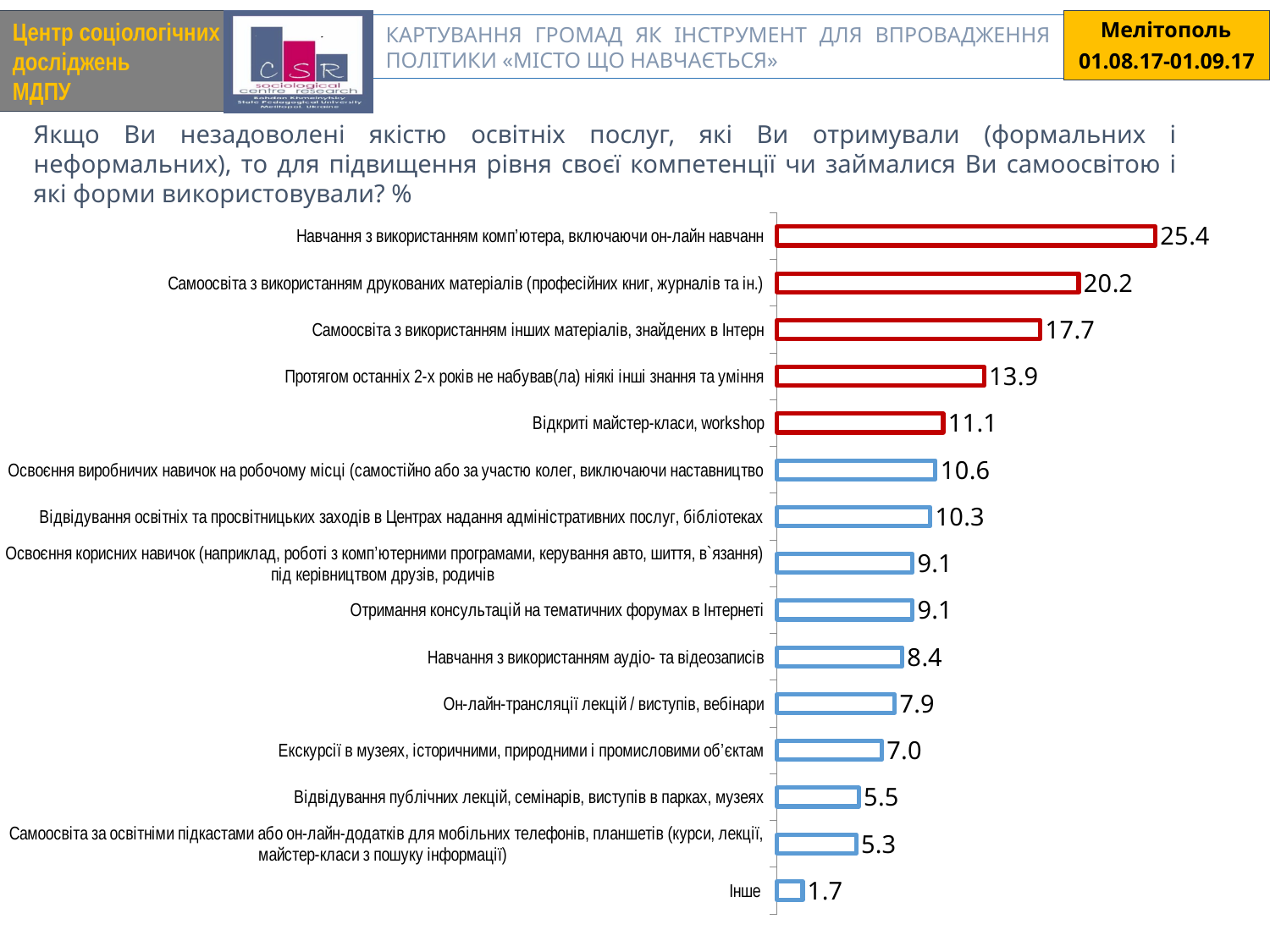
What is the difference between the values for "Навчання з використанням комп'ютера, включаючи он-лайн навчанн" and "Самоосвіта з використанням друкованих матеріалів (професійних книг, журналів та ін.)"? 5.2 Which category has the highest value in the chart? Навчання з використанням комп'ютера, включаючи он-лайн навчанн Which category has the lowest value in the chart? Інше What value is shown for "Навчання з використанням аудіо- та відеозаписів"? 8.4 What value is shown for "Відкриті майстер-класи, workshop"? 11.1 How many bars in the chart are outlined in red? 5 Which is larger: the value for "Екскурсії в музеях, історичними, природними і промисловими об'єктам" or the value for "Відвідування публічних лекцій, семінарів, виступів в парках, музеях"? Екскурсії в музеях, історичними, природними і промисловими об'єктам What is the difference between the values for "Протягом останніх 2-х років не набував(ла) ніякі інші знання та уміння" and "Відкриті майстер-класи, workshop"? 2.8 What kind of chart is shown on the slide? Bar chart How many categories are plotted in the chart? 15 What value is shown for "Отримання консультацій на тематичних форумах в Інтернеті"? 9.1 What value is shown for "Он-лайн-трансляції лекцій / виступів, вебінари"? 7.9